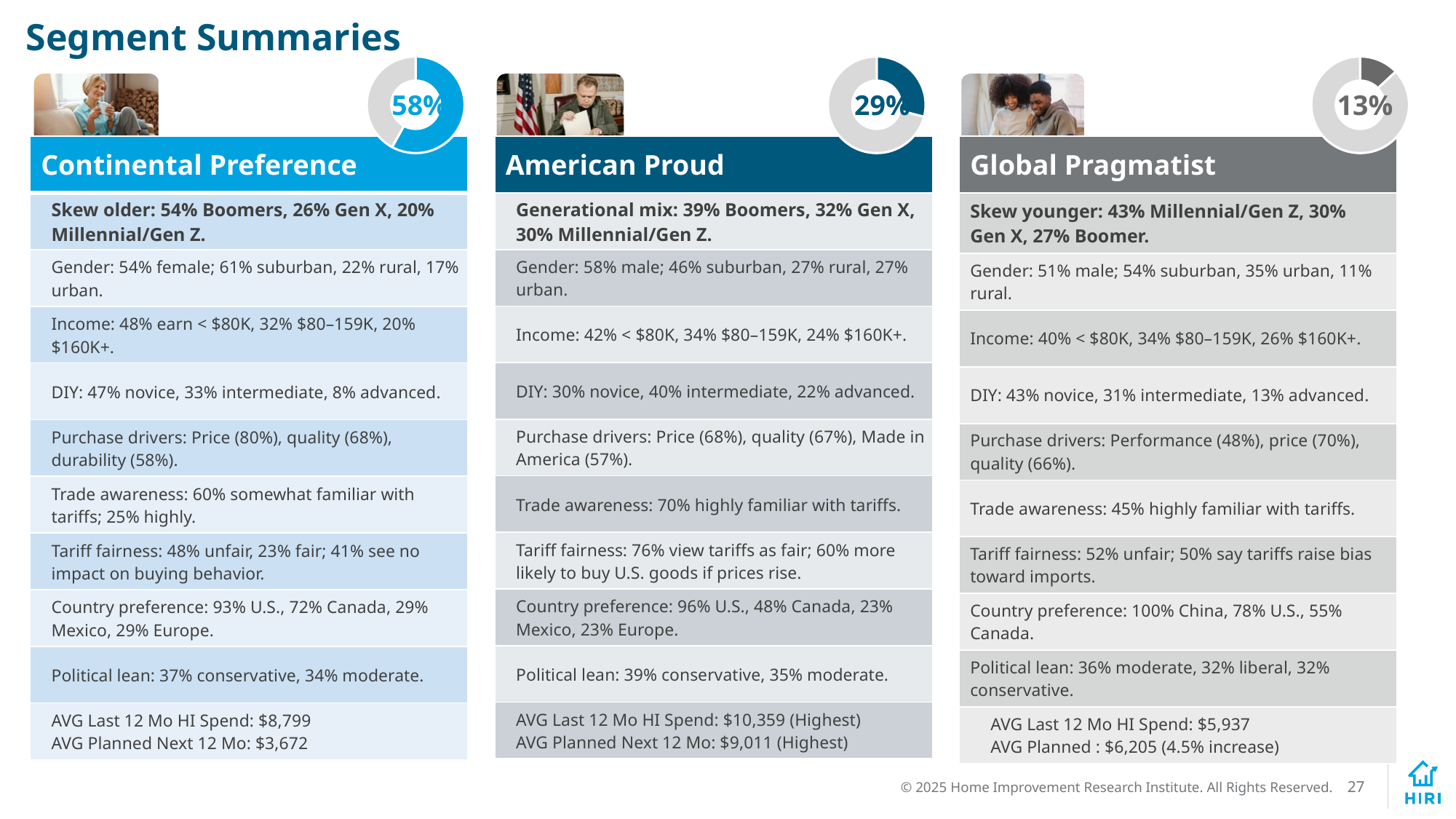
Which segment's donut chart shows the highest percentage? Continental Preference What kind of chart is used to show each segment's percentage at the top of the slide? Donut (pie) chart What percentage is shown in the donut chart above the Global Pragmatist segment? 13% What percentage is shown in the donut chart above the American Proud segment? 29% What colour is the filled portion of the Continental Preference donut chart? Light blue How many donut charts are on the slide? 3 What is the difference between the percentages shown in the Continental Preference and American Proud donut charts? 29 percentage points Which donut chart shows a larger percentage, American Proud or Global Pragmatist? American Proud What is the difference between the percentages shown in the American Proud and Global Pragmatist donut charts? 16 percentage points What do the three segment percentages in the donut charts add up to? 100% What percentage is shown in the donut chart above the Continental Preference segment? 58% Which segment's donut chart shows the lowest percentage? Global Pragmatist